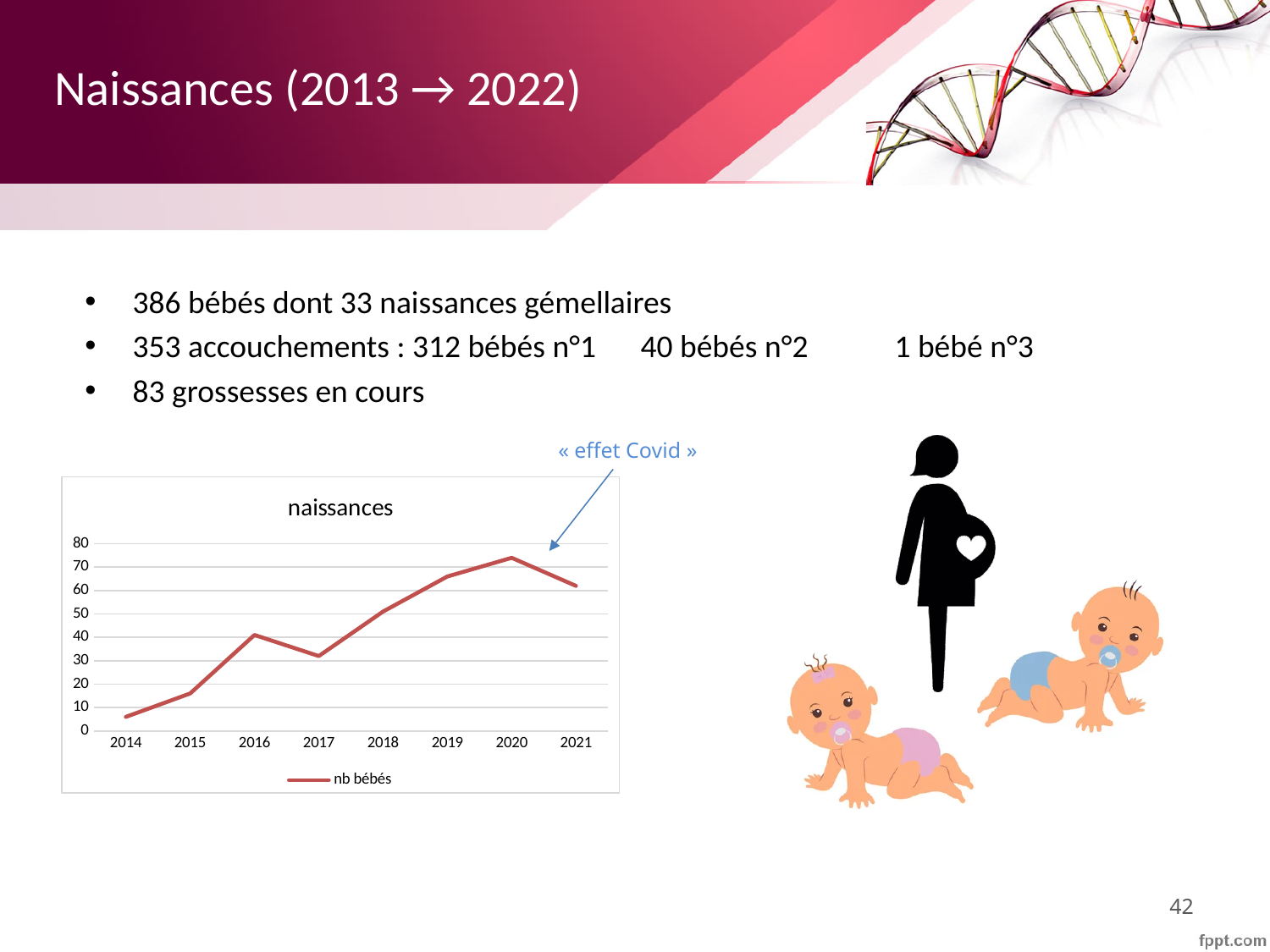
What series name does the chart legend show? nb bébés Does the value for nb bébés rise or fall from 2020 to 2021? fall Is the value for 2014 greater or less than 10? less What kind of chart is shown on the slide? line chart Is the value for 2020 greater or less than 70? greater Which year has the lowest value for nb bébés? 2014 How many series does the legend list? 1 Which year has the highest value for nb bébés? 2020 What is the title of the chart? naissances Is the value for 2017 greater or less than 40? less Which year has the larger value for nb bébés, 2016 or 2017? 2016 How many years are plotted on the x axis of the chart? 8